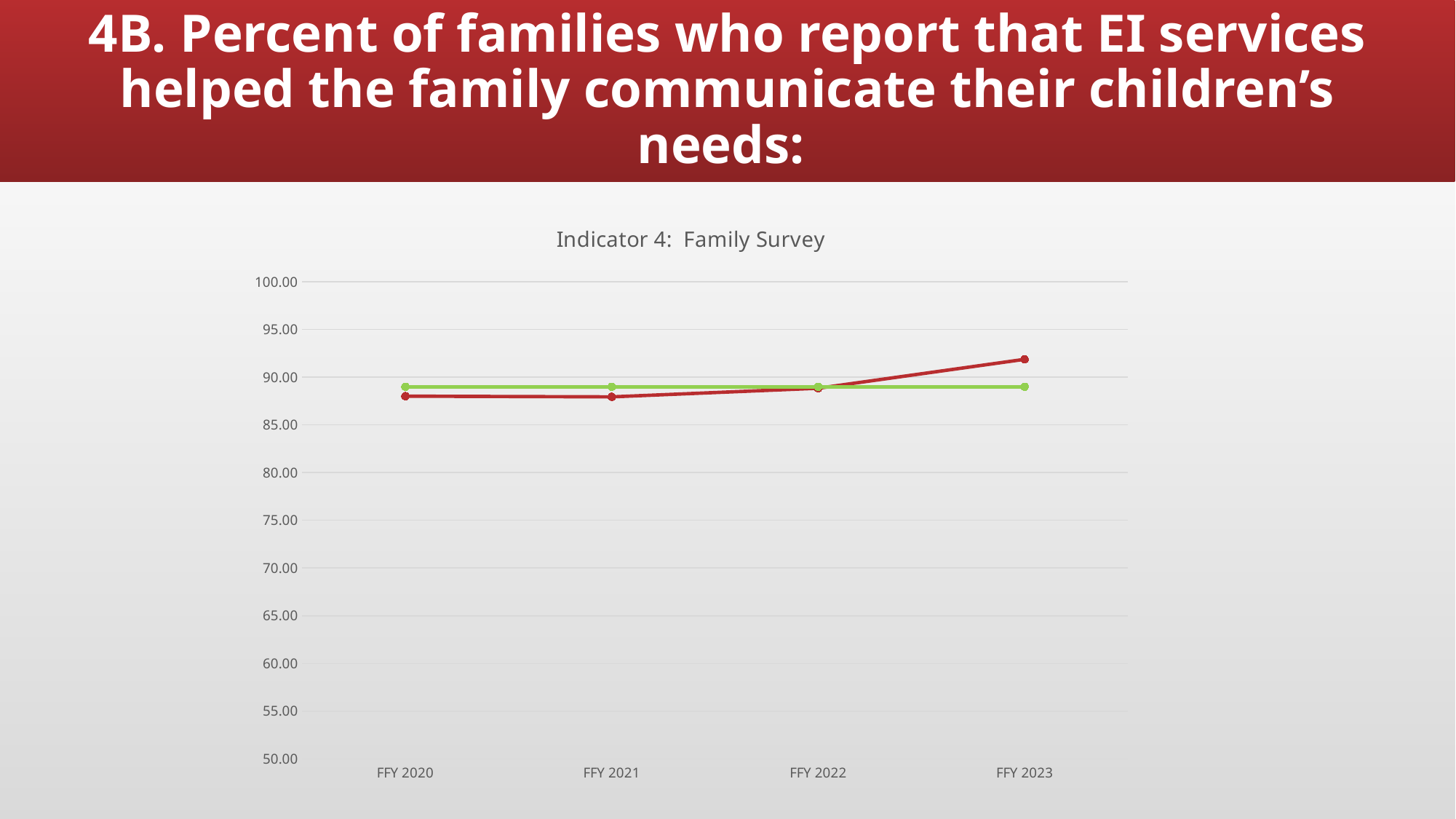
At FFY 2023, which line has the higher value, the red line or the green line? red line Is the value of the red line for FFY 2023 greater or less than 90? greater What is the title of the chart? Indicator 4: Family Survey Which is larger for the red line, the value for FFY 2020 or the value for FFY 2023? FFY 2023 Is the value of the green line for FFY 2022 greater or less than 95? less Is the value of the red line for FFY 2020 greater or less than 90? less Does the red line rise or fall from FFY 2021 to FFY 2023? rise How many lines are plotted on the chart? 2 How many FFY categories are shown on the x axis? 4 In which year does the red line reach its highest value? FFY 2023 What kind of chart is shown on the slide? line chart